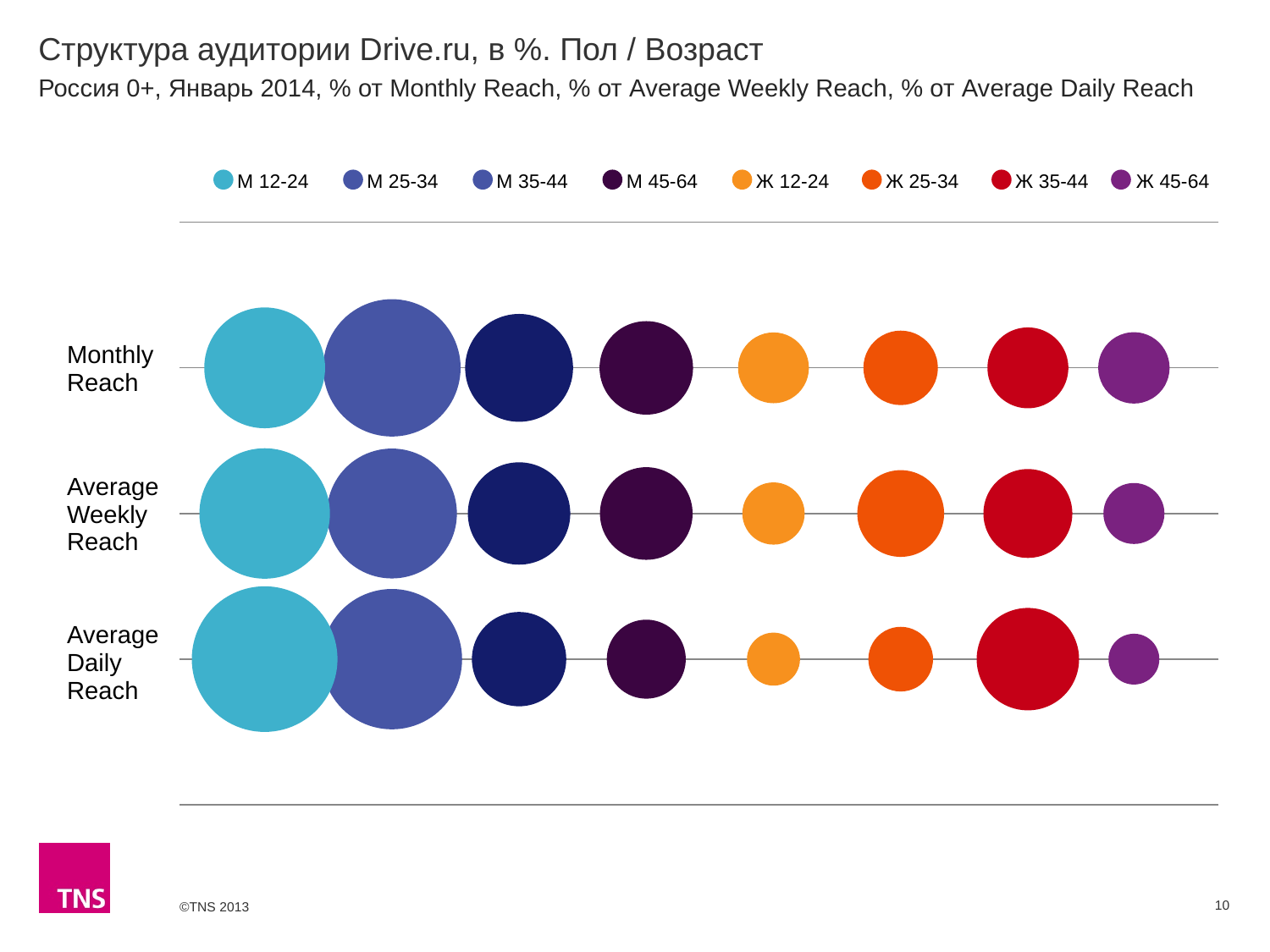
What kind of chart is shown on the slide? bubble chart What is the title of the slide's chart? Структура аудитории Drive.ru, в %. Пол / Возраст Which series has the largest bubble in the Monthly Reach row? М 25-34 How many series does the legend list? 8 In the Average Daily Reach row, which bubble is larger: М 12-24 or Ж 12-24? М 12-24 In the Average Weekly Reach row, which bubble is larger: Ж 25-34 or Ж 12-24? Ж 25-34 Does the Ж 35-44 bubble get larger or smaller going from Monthly Reach to Average Daily Reach? larger In the Monthly Reach row, which bubble is larger: М 25-34 or Ж 45-64? М 25-34 How many reach categories (rows) are plotted on the chart? 3 Which series has the smallest bubble in the Average Daily Reach row? Ж 45-64 Which series is shown in red in the legend? Ж 35-44 Does the Ж 45-64 bubble get larger or smaller going from Monthly Reach to Average Daily Reach? smaller